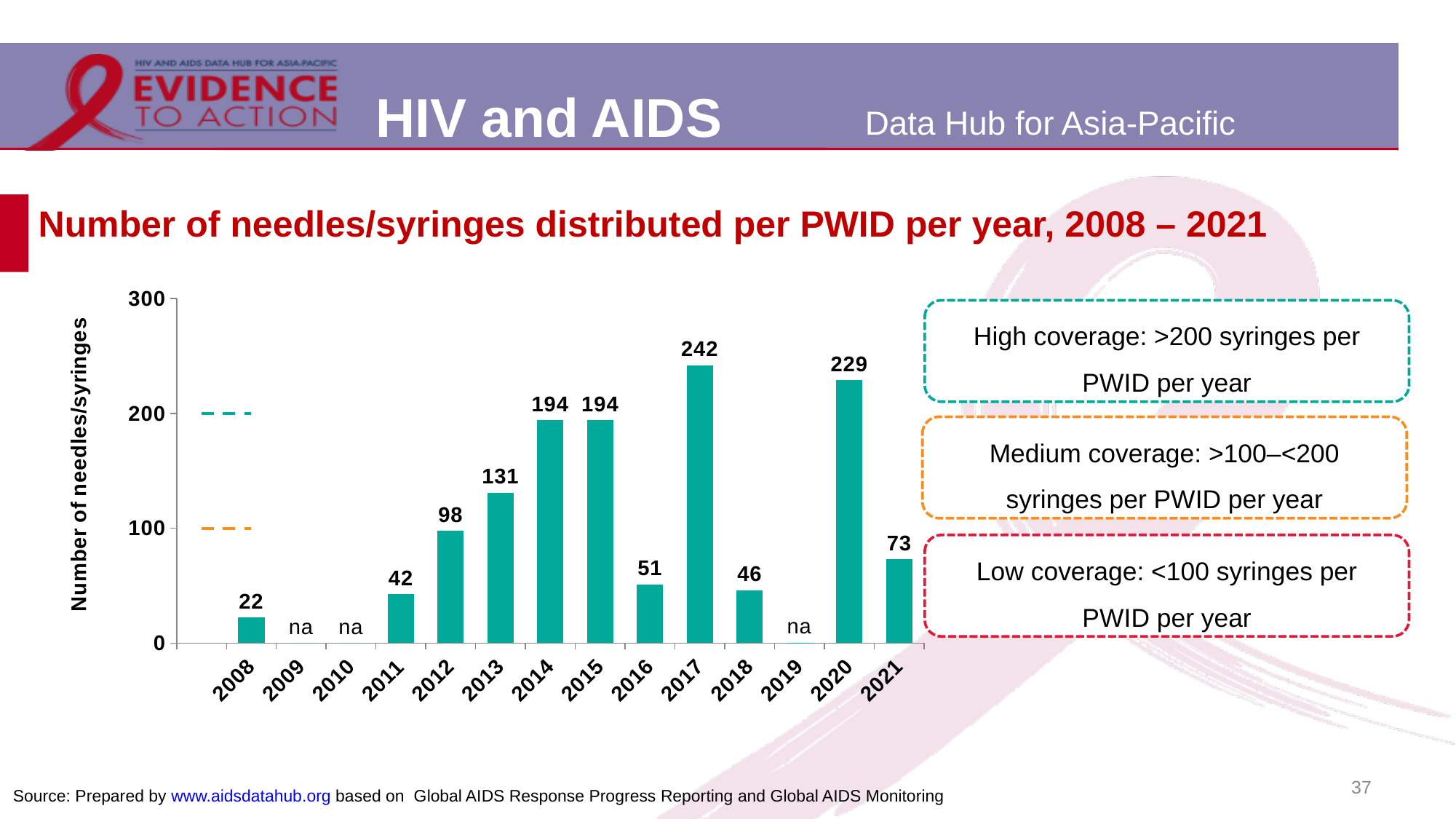
What is the difference between the values for 2017 and 2020? 13 What is the value shown for 2020? 229 What is the label of the y axis? Number of needles/syringes How many years are marked 'na' on the chart? 3 Which is larger, the value for 2016 or the value for 2018? 2016 What is the number of needles/syringes distributed per PWID per year in 2017? 242 Which year has the highest number of needles/syringes distributed per PWID? 2017 Is the value for 2013 greater or less than 100? greater Among the years with a plotted value, which year has the lowest number of needles/syringes distributed per PWID? 2008 What kind of chart is shown on the slide? Bar chart What is the value shown for 2008? 22 How many years are labelled on the x axis? 14